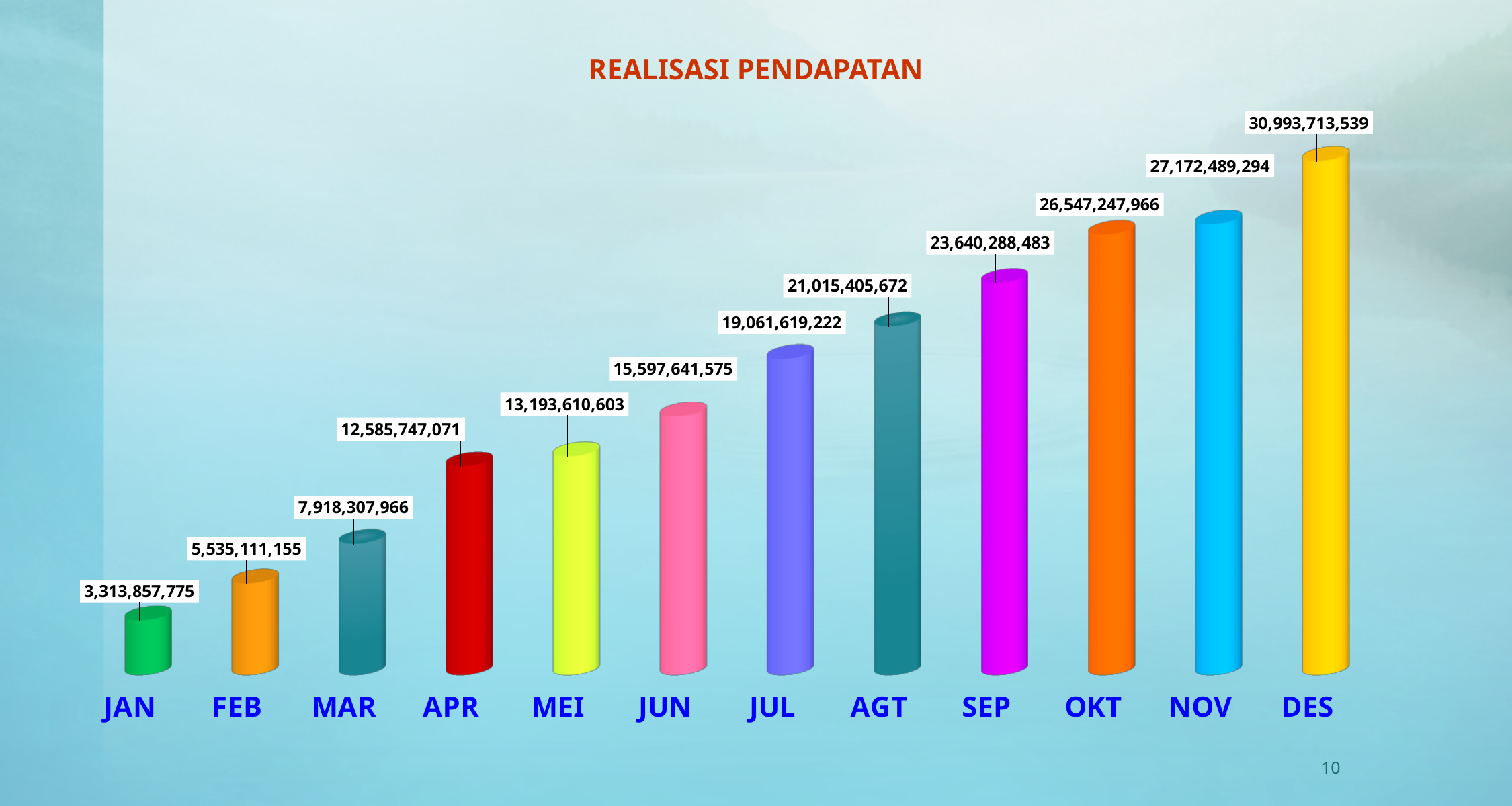
What is the difference between the values for DES and NOV? 3,821,224,245 What is the value for JAN? 3,313,857,775 What type of chart is shown on the slide? Bar chart Which month has the lowest value? JAN Do the values rise or fall from JAN to DES? Rise What is the title of the chart? REALISASI PENDAPATAN How many months are plotted in the chart? 12 Which is larger, the value for APR or the value for MEI? MEI What is the value for SEP? 23,640,288,483 What is the value for DES? 30,993,713,539 What is the value for JUN? 15,597,641,575 Which month has the highest value? DES